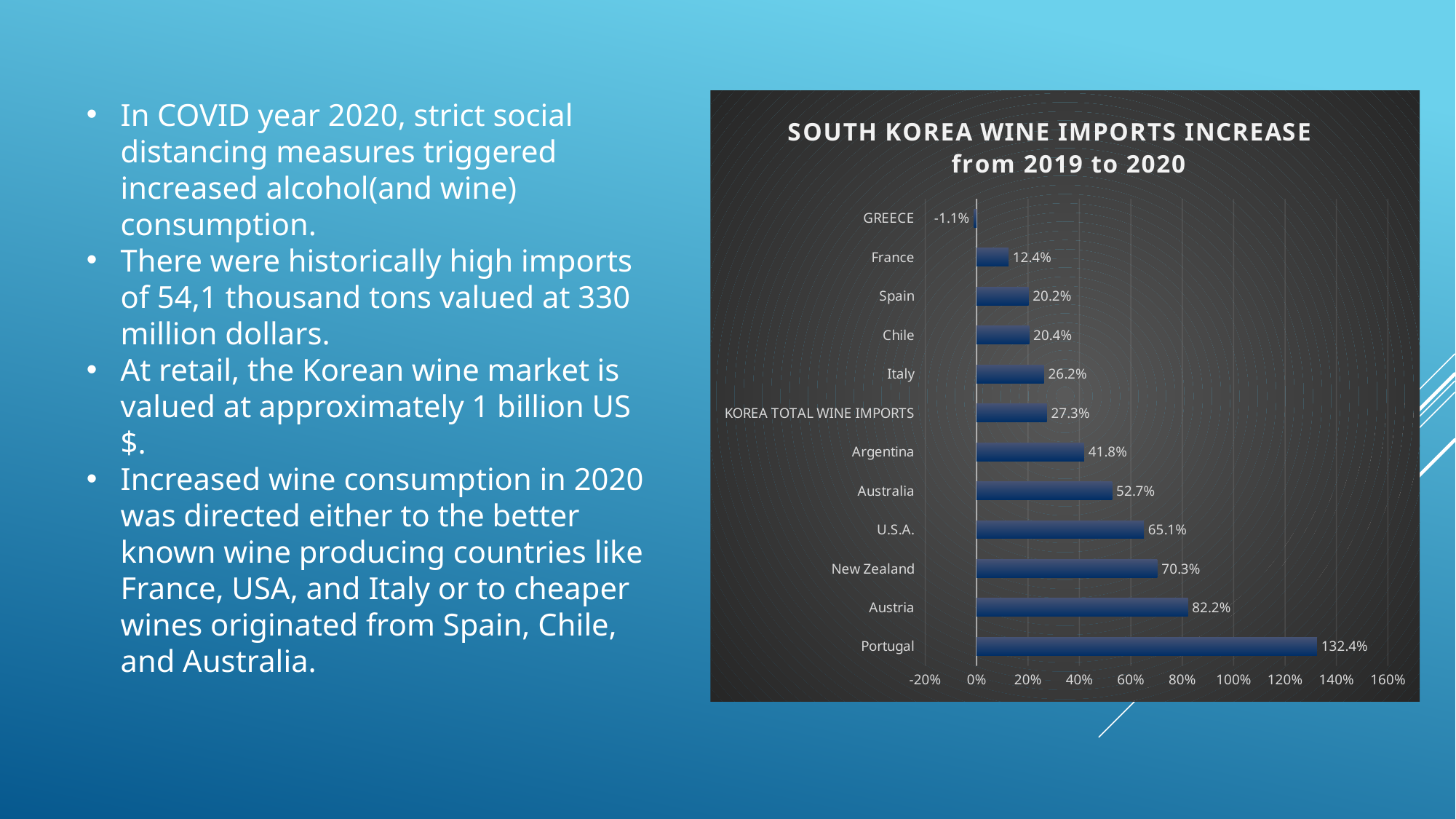
How many categories are plotted on the chart? 12 What kind of chart is shown on the slide? Bar chart Which category has the lowest value on the chart? GREECE What is the value shown for KOREA TOTAL WINE IMPORTS? 27.3% What is the value shown for GREECE? -1.1% What is the difference between the values for Austria and New Zealand? 11.9% What is the wine imports increase value for Portugal? 132.4% What is the title of the chart? SOUTH KOREA WINE IMPORTS INCREASE from 2019 to 2020 Is the value for Argentina greater or less than 40%? greater Which has a larger value, U.S.A. or Australia? U.S.A. Which country has the highest wine imports increase? Portugal What is the value shown for France? 12.4%